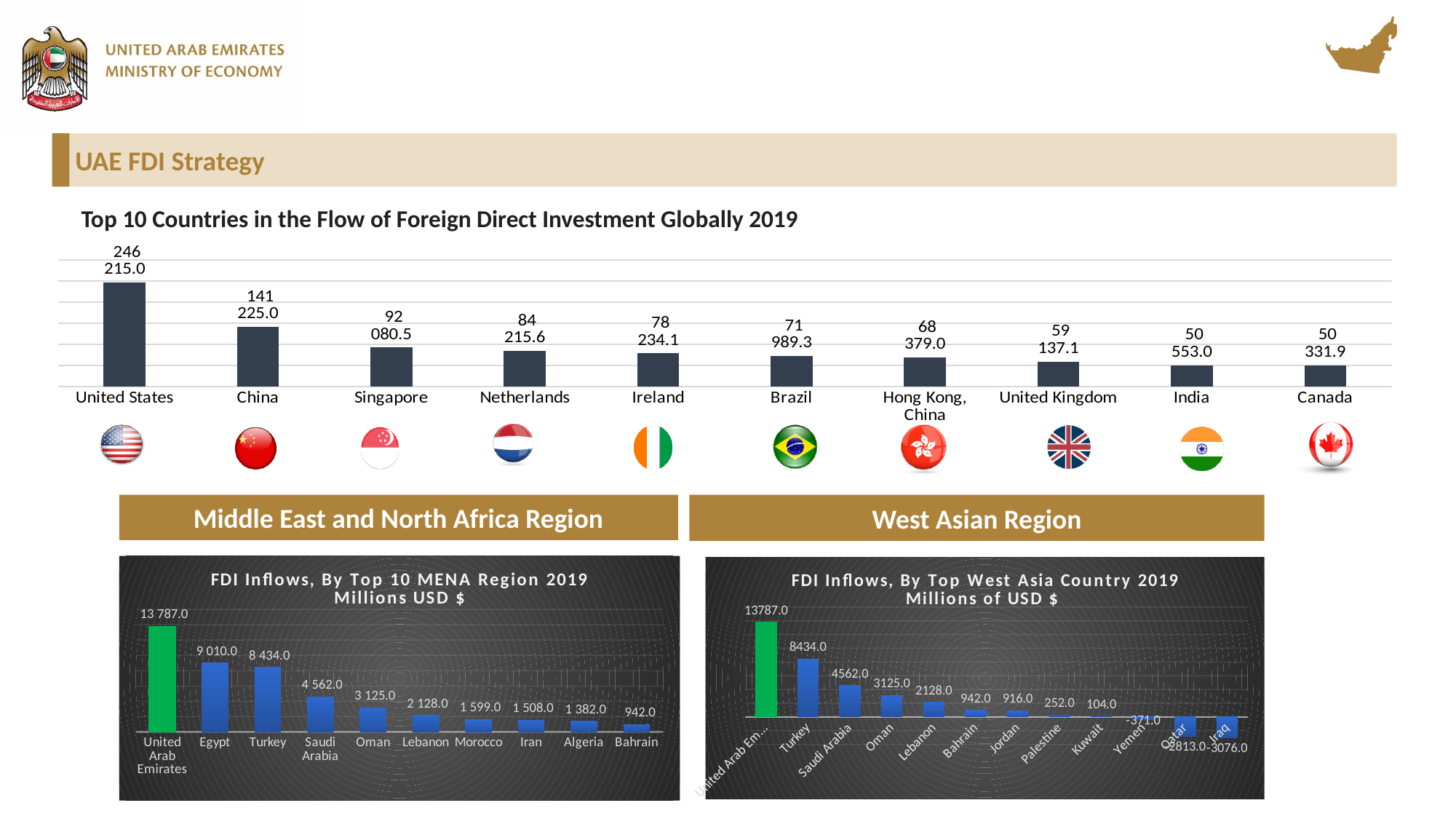
In the bottom-left chart 'FDI Inflows, By Top 10 MENA Region 2019', what is the difference between the values for Turkey and Saudi Arabia? 3 872.0 In the bottom-left chart 'FDI Inflows, By Top 10 MENA Region 2019', what is the value for Egypt? 9 010.0 In the top chart 'Top 10 Countries in the Flow of Foreign Direct Investment Globally 2019', which country has the lowest value? Canada In the bottom-left chart 'FDI Inflows, By Top 10 MENA Region 2019', which country has the highest value? United Arab Emirates What type of chart is the bottom-right chart 'FDI Inflows, By Top West Asia Country 2019'? bar chart In the top chart 'Top 10 Countries in the Flow of Foreign Direct Investment Globally 2019', what is the value shown for the United States? 246 215.0 In the top chart 'Top 10 Countries in the Flow of Foreign Direct Investment Globally 2019', how many countries are shown? 10 In the bottom-right chart 'FDI Inflows, By Top West Asia Country 2019', how many countries are shown? 12 In the bottom-right chart 'FDI Inflows, By Top West Asia Country 2019', what is the value for Iraq? -3076.0 In the bottom-left chart 'FDI Inflows, By Top 10 MENA Region 2019', which is larger, the value for Iran or the value for Algeria? Iran In the top chart 'Top 10 Countries in the Flow of Foreign Direct Investment Globally 2019', what is the value shown for Brazil? 71 989.3 In the top chart 'Top 10 Countries in the Flow of Foreign Direct Investment Globally 2019', do the values rise or fall from left to right? fall